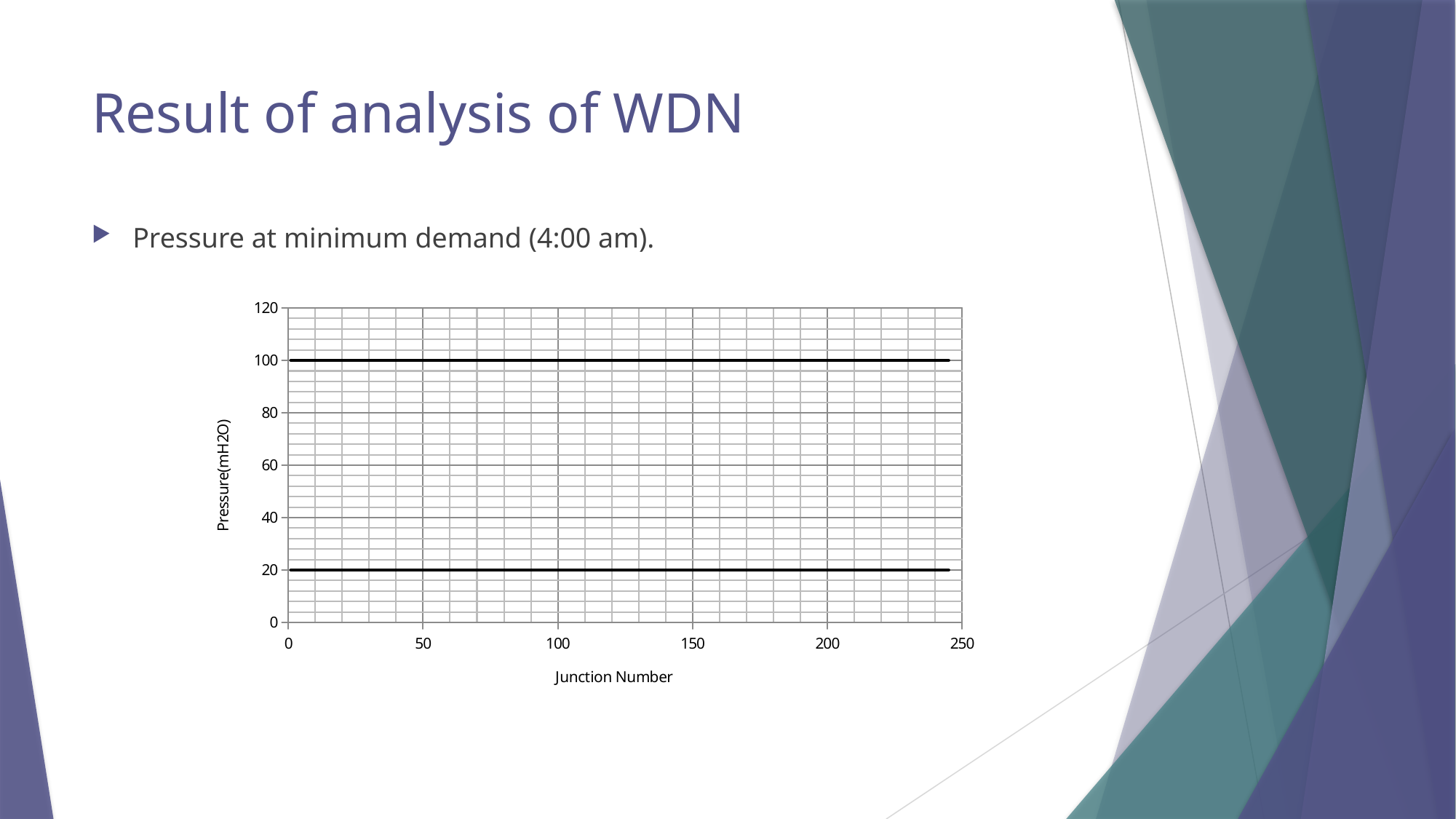
How many horizontal lines are plotted on the chart? 2 At what pressure value does the lower horizontal line sit? 20 Is the value of the upper line greater or less than 80? greater Does the lower line rise, fall, or stay flat as the junction number increases? stays flat What is the difference in pressure between the upper line and the lower line? 80 What is the label of the y axis of the chart? Pressure(mH2O) Is the value of the lower line greater or less than 40? less What kind of chart is shown on the slide? line chart Which line has the larger pressure value, the upper line or the lower line? the upper line What is the label of the x axis of the chart? Junction Number At what pressure value does the upper horizontal line sit? 100 Does the upper line rise, fall, or stay flat as the junction number increases? stays flat